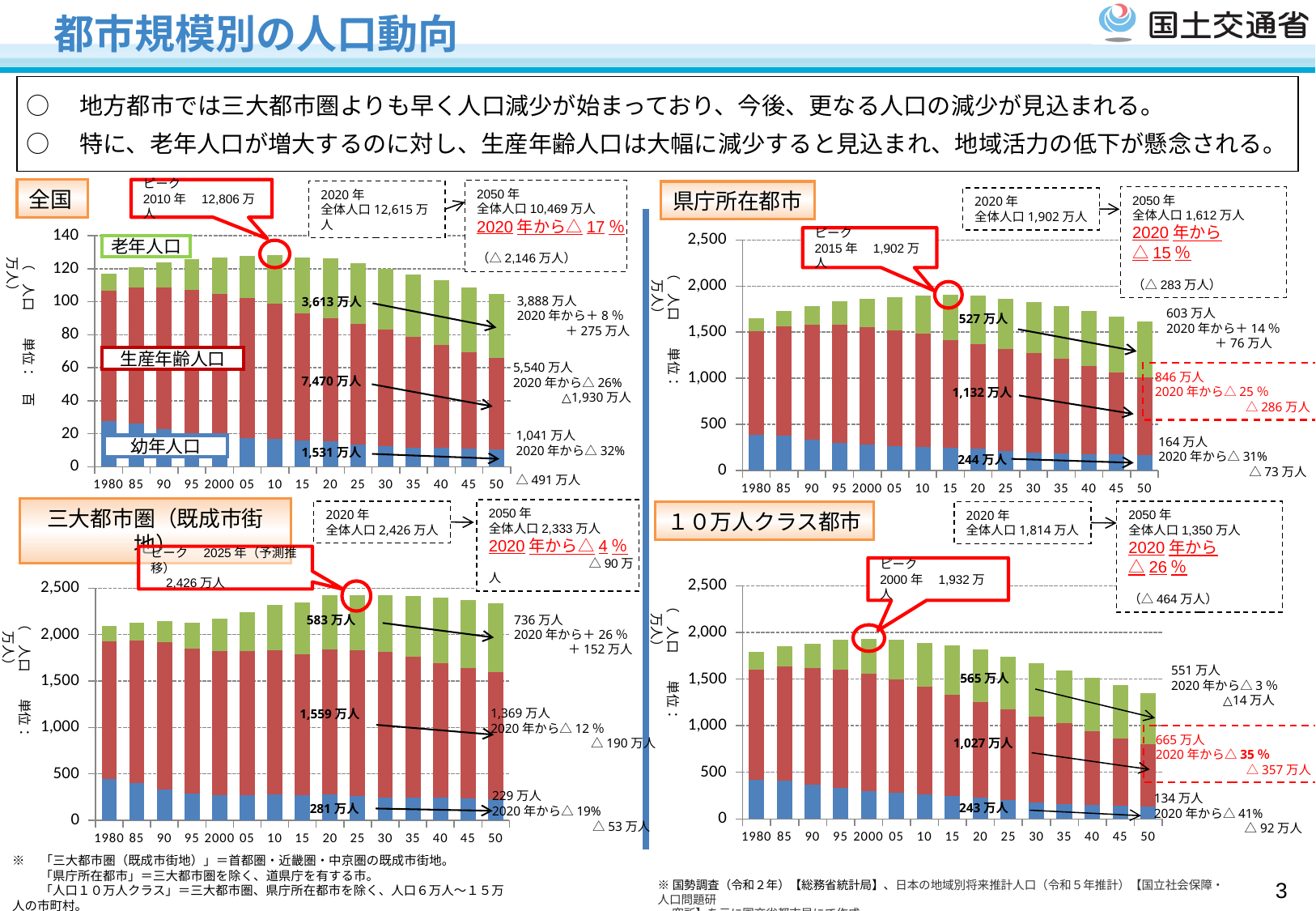
In the 三大都市圏（既成市街地） chart, in which year is the population peak indicated? 2025年 How many years (bars) are shown on the x axis of the 県庁所在都市 chart? 15 What kind of chart is used in the 全国 panel? Stacked bar chart In the 全国 chart, what is the 生産年齢人口 value for 2020? 7,470万人 In the 県庁所在都市 chart, is the total bar height for 1980 greater or less than 1,500? greater Among the four charts, which one has the highest total population in 2020? 全国 In the 10万人クラス都市 chart, what is the 生産年齢人口 value for 2050? 665万人 In the 10万人クラス都市 chart, does the total population rise or fall from 2000 to 2050? fall In the 県庁所在都市 chart, what is the 老年人口 value for 2050? 603万人 Which is larger: the 2020 老年人口 in the 三大都市圏（既成市街地） chart or the 2020 老年人口 in the 10万人クラス都市 chart? 三大都市圏（既成市街地） In the 全国 chart, what is the difference between the total population in 2020 (12,615万人) and in 2050 (10,469万人)? 2,146万人 How many population categories are stacked in each bar of the 全国 chart? 3